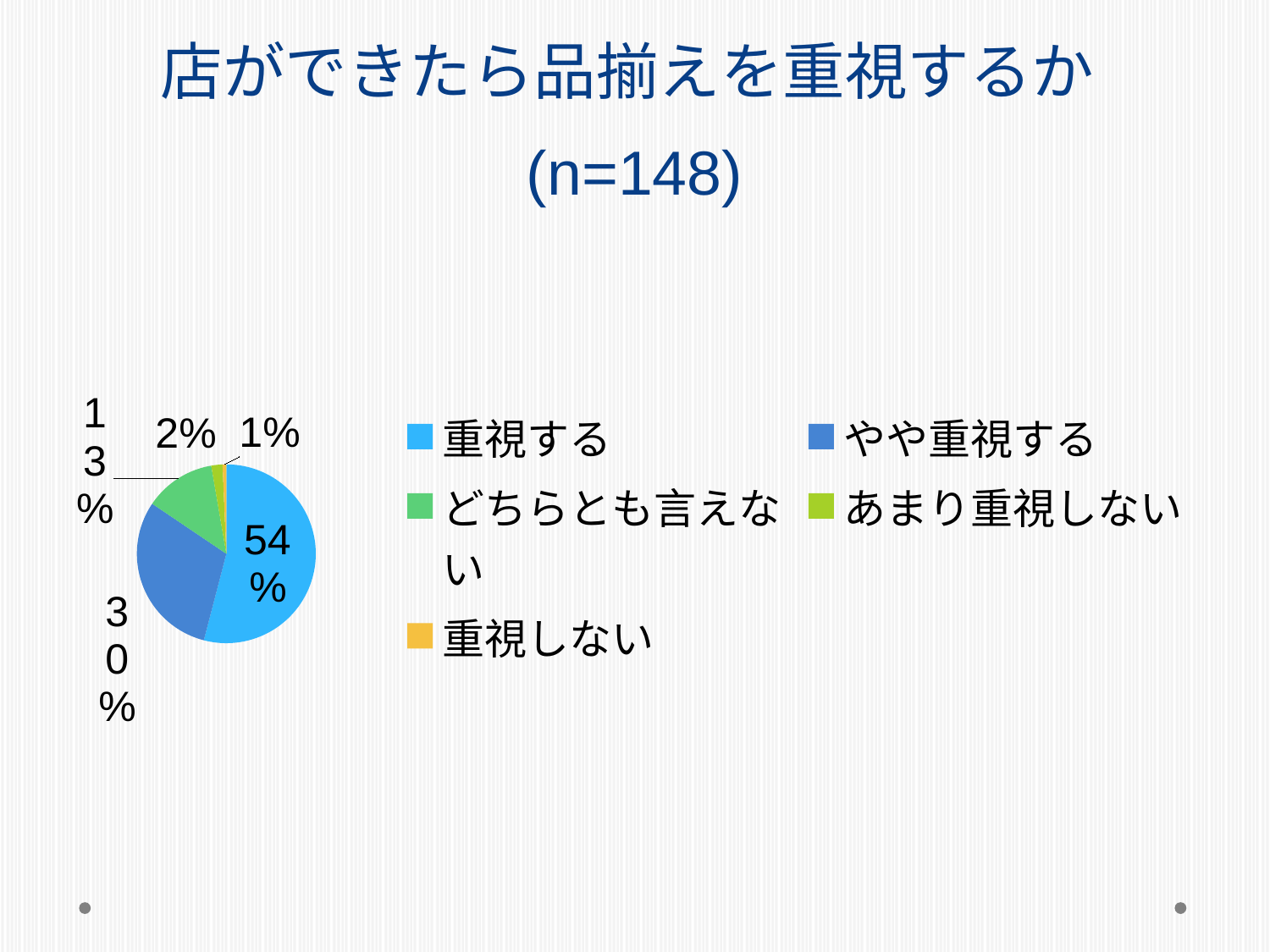
What is the difference between the shares of 重視する and やや重視する? 24% Which category has the largest share of the pie? 重視する What share of the pie does やや重視する have? 30% What share of the pie does 重視する have? 54% What share of the pie does あまり重視しない have? 2% Which is larger, the share of やや重視する or the share of どちらとも言えない? やや重視する Which category has the smallest share of the pie? 重視しない What is the sample size shown in the chart title? n=148 How many categories does the legend list? 5 What kind of chart is shown on the slide? pie chart